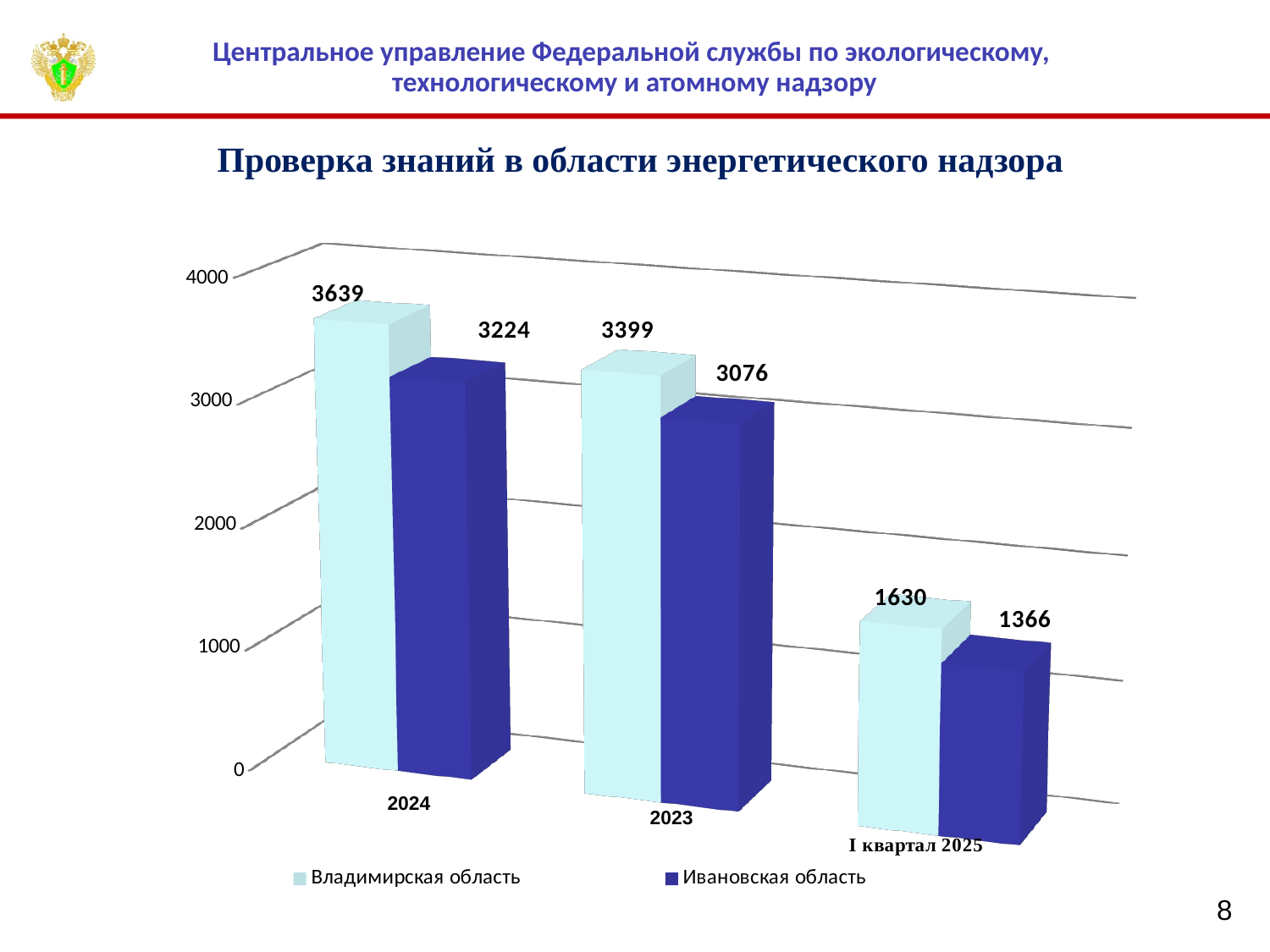
Which category has the lowest value for Ивановская область? I квартал 2025 What is the value for Владимирская область in 2024? 3639 What kind of chart is shown on the slide? bar chart What is the value for Ивановская область in 2023? 3076 How many series does the legend list? 2 Which is larger in 2023: Владимирская область or Ивановская область? Владимирская область Is the value for Владимирская область in I квартал 2025 greater or less than 2000? less What is the title of the chart? Проверка знаний в области энергетического надзора What is the value for Ивановская область in I квартал 2025? 1366 How many categories are shown on the x axis? 3 What is the difference between Владимирская область and Ивановская область in 2024? 415 Which category has the highest value for Владимирская область? 2024